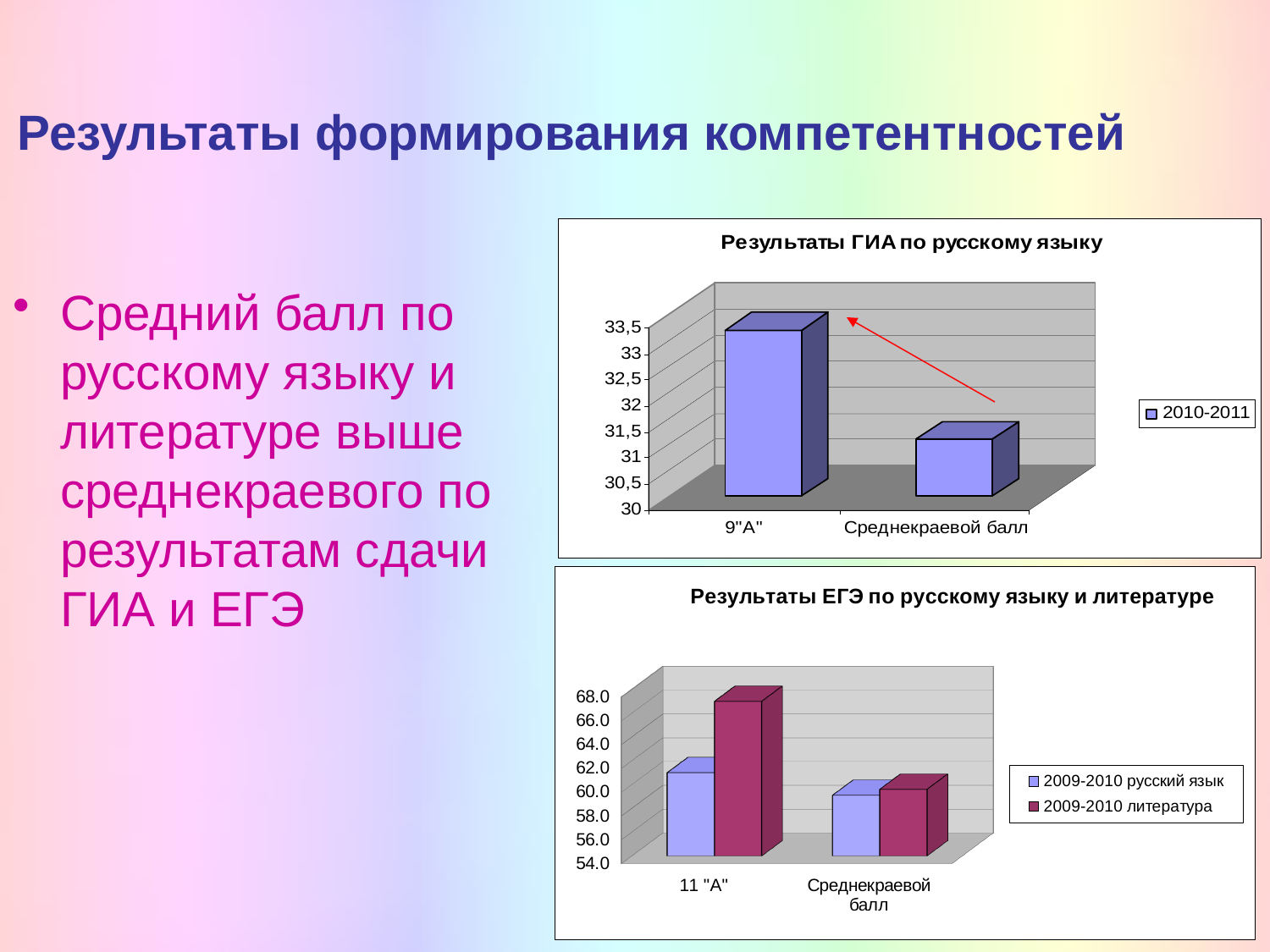
In the chart titled "Результаты ГИА по русскому языку", what kind of chart is shown? bar chart In the chart titled "Результаты ГИА по русскому языку", how many categories are shown on the x axis? 2 In the chart titled "Результаты ЕГЭ по русскому языку и литературе", is the value of 2009-2010 литература for 11 "А" greater or less than 64.0? greater In the chart titled "Результаты ЕГЭ по русскому языку и литературе", how many series does the legend list? 2 In the chart titled "Результаты ГИА по русскому языку", how many series does the legend list? 1 In the chart titled "Результаты ГИА по русскому языку", is the value for 9"А" greater or less than 32? greater In the chart titled "Результаты ЕГЭ по русскому языку и литературе", which category has the highest value for 2009-2010 русский язык? 11 "А" In the chart titled "Результаты ЕГЭ по русскому языку и литературе", is the value of 2009-2010 литература for Среднекраевой балл greater or less than 62.0? less In the chart titled "Результаты ЕГЭ по русскому языку и литературе", which series has the higher value for 11 "А": 2009-2010 русский язык or 2009-2010 литература? 2009-2010 литература In the chart titled "Результаты ГИА по русскому языку", which category has the highest value? 9"А" In the chart titled "Результаты ГИА по русскому языку", what series name is shown in the legend? 2010-2011